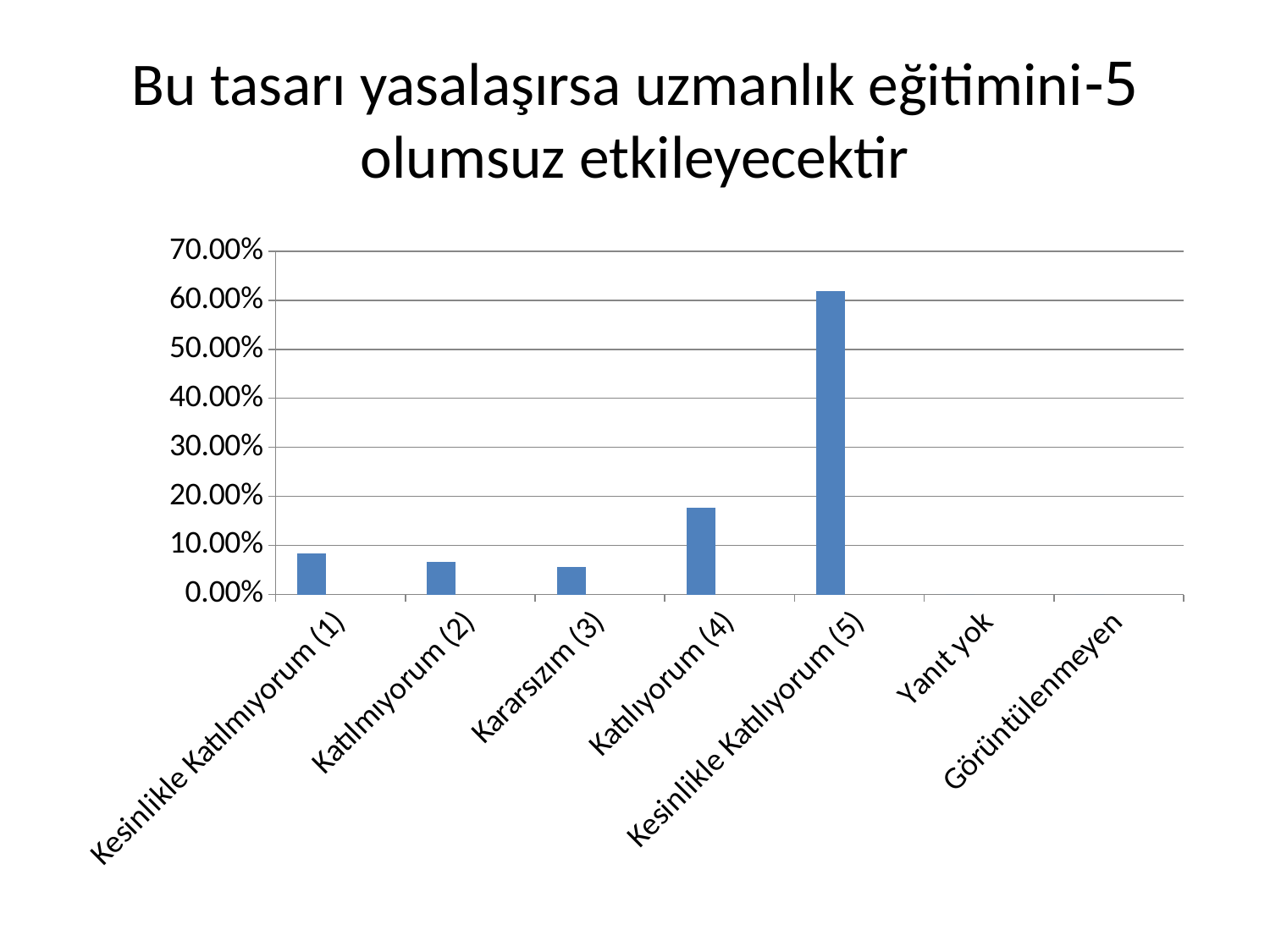
Is the value for Kararsızım (3) greater or less than 10.00%? less Which is larger, the value for Katılıyorum (4) or the value for Kesinlikle Katılmıyorum (1)? Katılıyorum (4) What is the highest value shown on the y axis of the chart? 70.00% Which is larger, the value for Kesinlikle Katılıyorum (5) or the value for Katılıyorum (4)? Kesinlikle Katılıyorum (5) How many categories are shown on the x axis of the chart? 7 What kind of chart is shown on the slide? bar chart What is the title of the slide? Bu tasarı yasalaşırsa uzmanlık eğitimini-5 olumsuz etkileyecektir Which category has the highest value in the chart? Kesinlikle Katılıyorum (5) Is the value for Kesinlikle Katılmıyorum (1) greater or less than 10.00%? less Is the value for Kesinlikle Katılıyorum (5) greater or less than 60.00%? greater